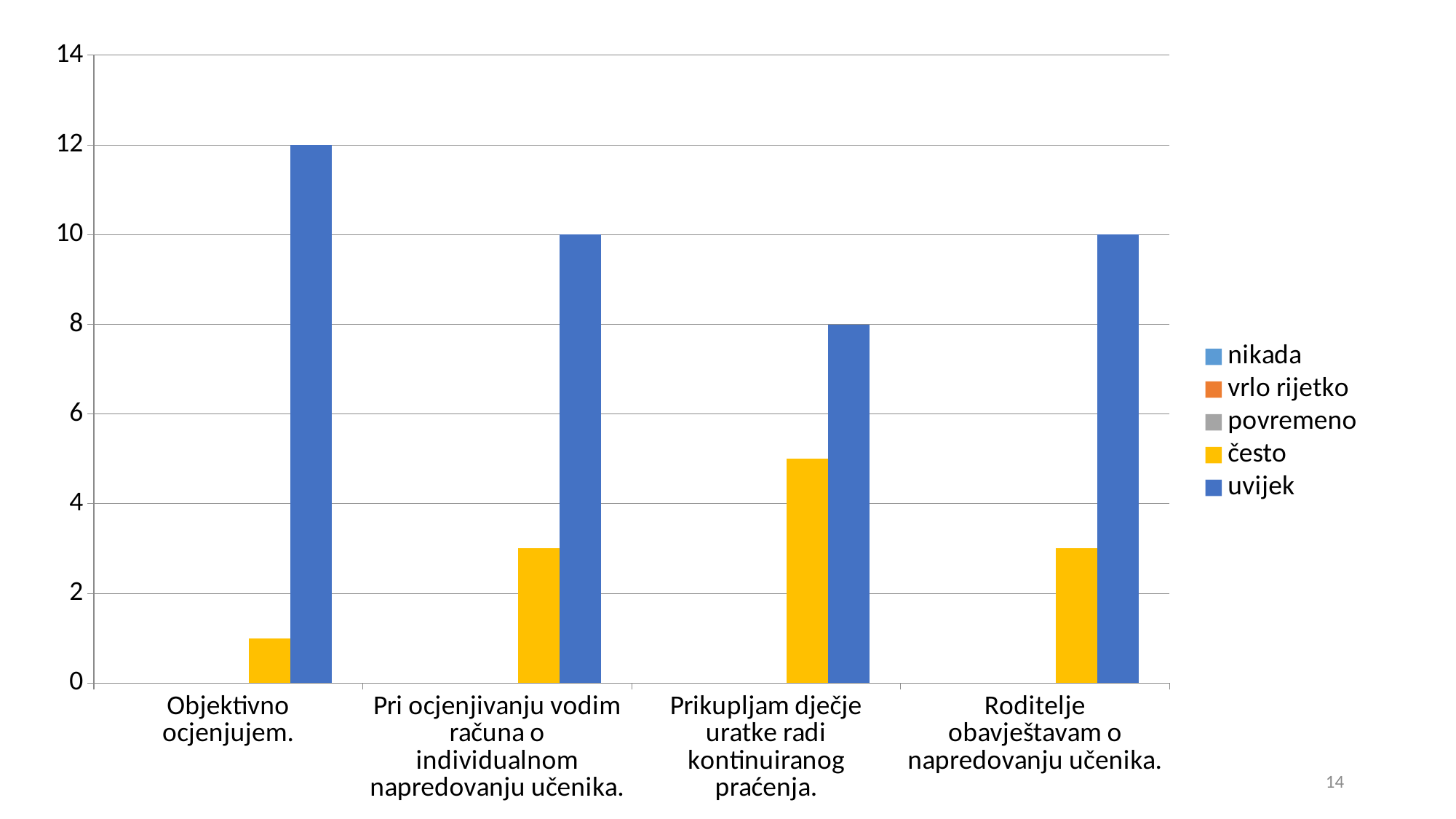
For which category is the "uvijek" value lowest? Prikupljam dječje uratke radi kontinuiranog praćenja. For which category is the "uvijek" value highest? Objektivno ocjenjujem. What is the value of the "uvijek" series for "Prikupljam dječje uratke radi kontinuiranog praćenja."? 8 What is the difference between the "uvijek" values for "Objektivno ocjenjujem." and "Prikupljam dječje uratke radi kontinuiranog praćenja."? 4 Is the "često" value for "Prikupljam dječje uratke radi kontinuiranog praćenja." greater or less than 4? greater What is the value of the "uvijek" series for "Objektivno ocjenjujem."? 12 What is the value of the "uvijek" series for "Roditelje obavještavam o napredovanju učenika."? 10 Is the "često" value for "Objektivno ocjenjujem." greater or less than 2? less How many series does the legend list? 5 How many categories are shown on the x axis? 4 For "Roditelje obavještavam o napredovanju učenika.", which series has the larger value, "često" or "uvijek"? uvijek What kind of chart is shown on the slide? bar chart